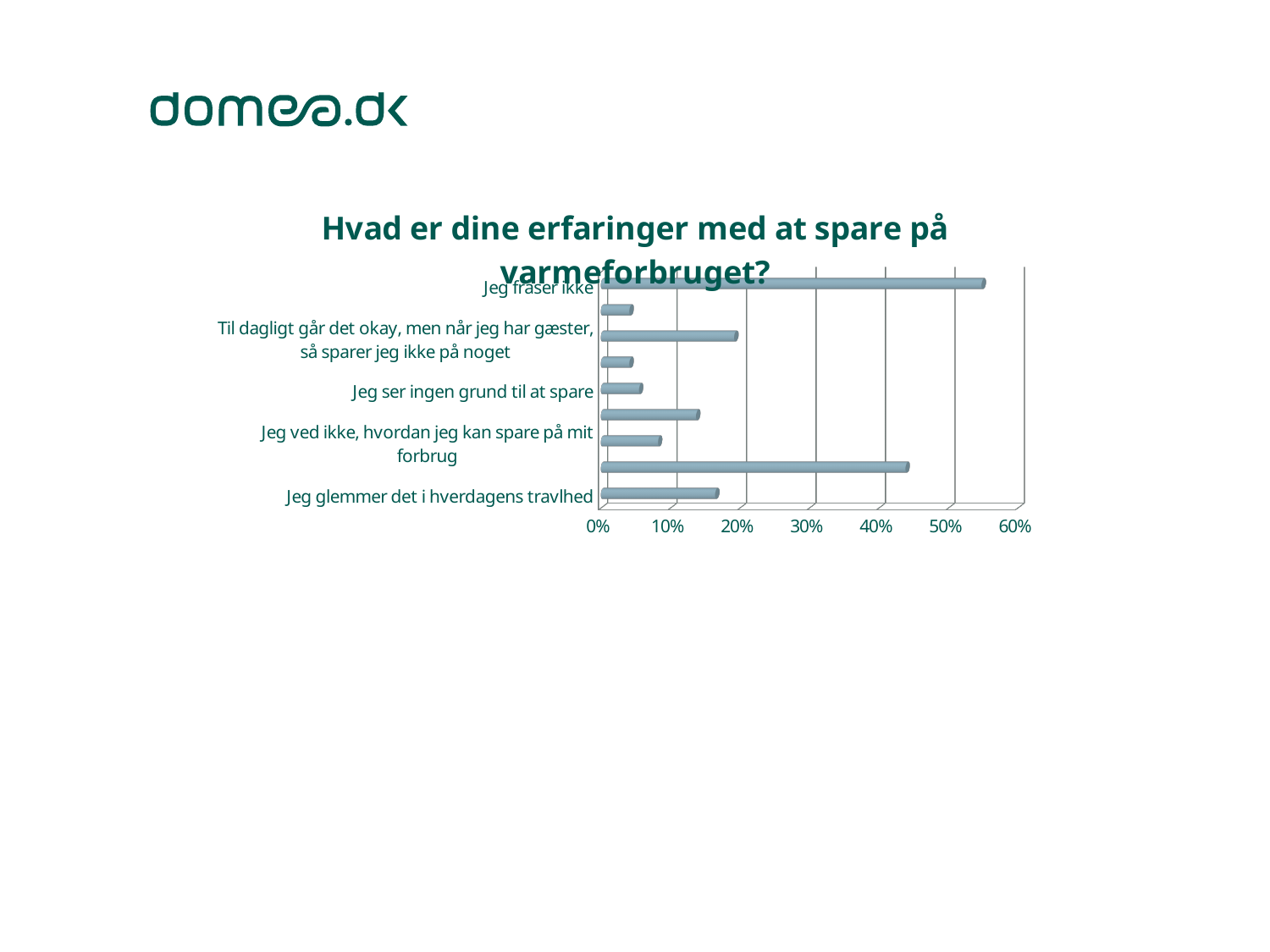
What is the highest value shown on the horizontal axis? 60% Is the value for "Jeg ved ikke, hvordan jeg kan spare på mit forbrug" greater or less than 10%? less Is the value for "Til dagligt går det okay, men når jeg har gæster, så sparer jeg ikke på noget" greater or less than 10%? greater Is the value for "Jeg ser ingen grund til at spare" greater or less than 10%? less Which is larger: the value for "Til dagligt går det okay, men når jeg har gæster, så sparer jeg ikke på noget" or for "Jeg ser ingen grund til at spare"? Til dagligt går det okay, men når jeg har gæster, så sparer jeg ikke på noget How many bars are plotted in the chart? 9 Which is larger: the value for "Jeg fråser ikke" or for "Jeg glemmer det i hverdagens travlhed"? Jeg fråser ikke What kind of chart is shown on the slide? Bar chart What is the title of the chart? Hvad er dine erfaringer med at spare på varmeforbruget? Which labelled category has the highest value? Jeg fråser ikke